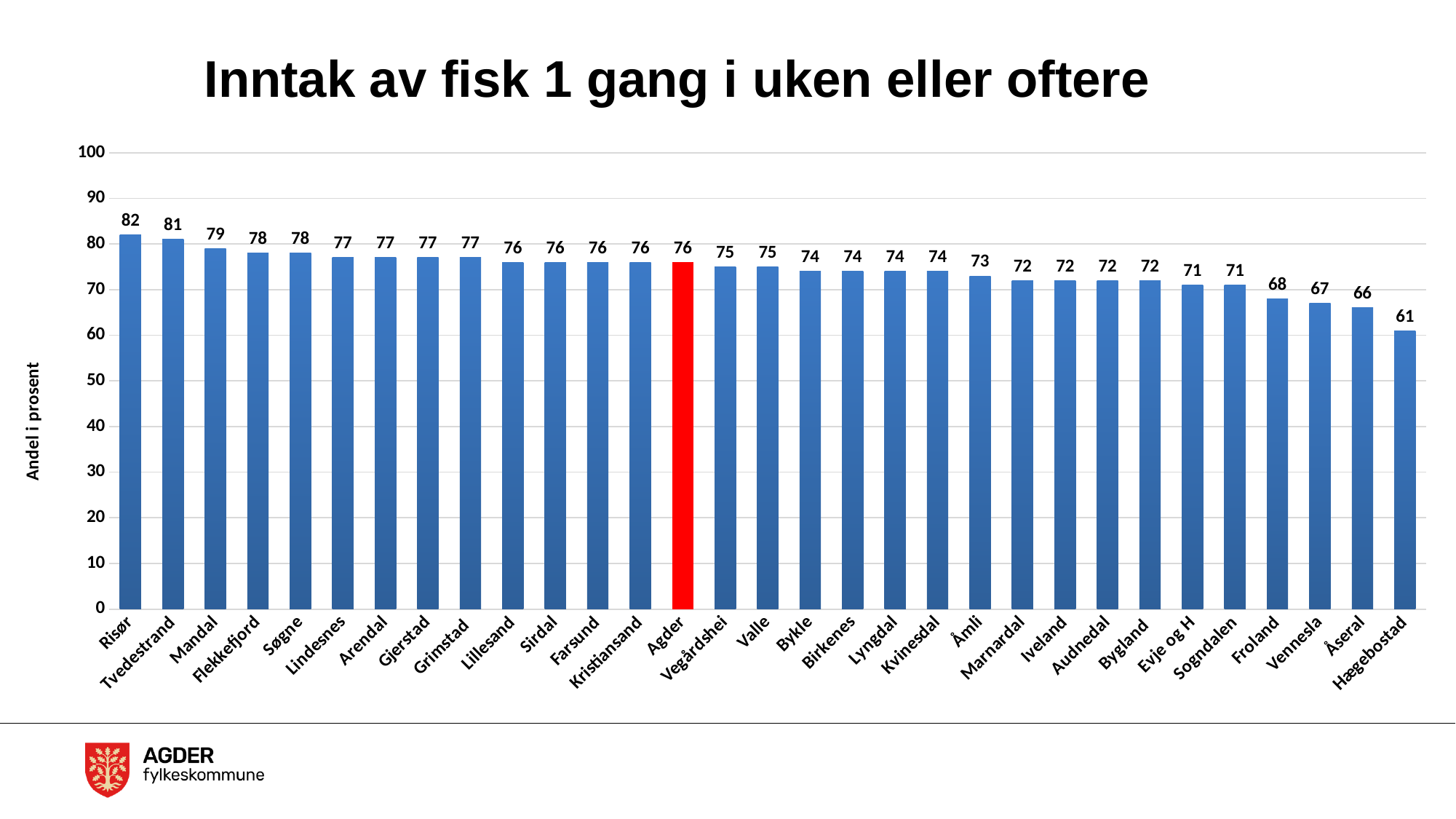
What is the difference between the values for Risør and Hægebostad? 21 Which category has the lowest value? Hægebostad What kind of chart is this? Bar chart Which category has the highest value? Risør What is the title of the chart? Inntak av fisk 1 gang i uken eller oftere What is the value for Froland? 68 Do the values rise or fall from left to right along the x axis? Fall What is the value for Agder, shown by the red bar? 76 Which is larger, the value for Mandal or the value for Vennesla? Mandal What is the value for Risør? 82 How many categories are shown on the x axis? 31 What is the value for Hægebostad? 61